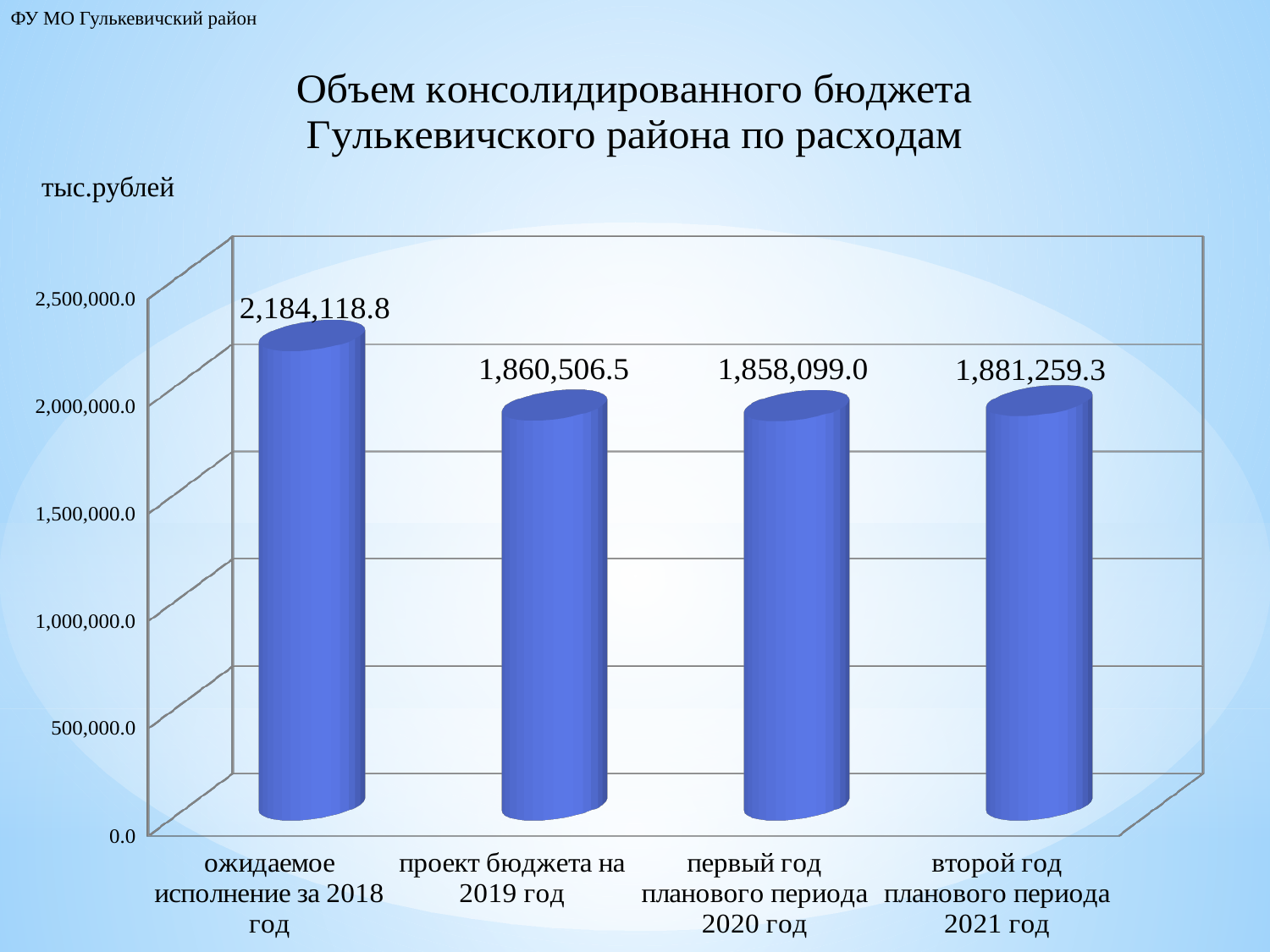
Which category has the highest value? ожидаемое исполнение за 2018 год What is the value for 'ожидаемое исполнение за 2018 год'? 2,184,118.8 Which is larger: the value for 2021 (второй год планового периода) or the value for 2019 (проект бюджета)? второй год планового периода 2021 год In what units are the values on the chart given? тыс.рублей Is the value for 'ожидаемое исполнение за 2018 год' greater or less than 2,000,000.0? greater What kind of chart is shown on the slide? bar chart What is the difference between the value for 2018 (ожидаемое исполнение) and the value for 2019 (проект бюджета)? 323,612.3 How many categories are shown on the chart? 4 What is the value for 'проект бюджета на 2019 год'? 1,860,506.5 What is the value for 'второй год планового периода 2021 год'? 1,881,259.3 What is the value for 'первый год планового периода 2020 год'? 1,858,099.0 Which category has the lowest value? первый год планового периода 2020 год